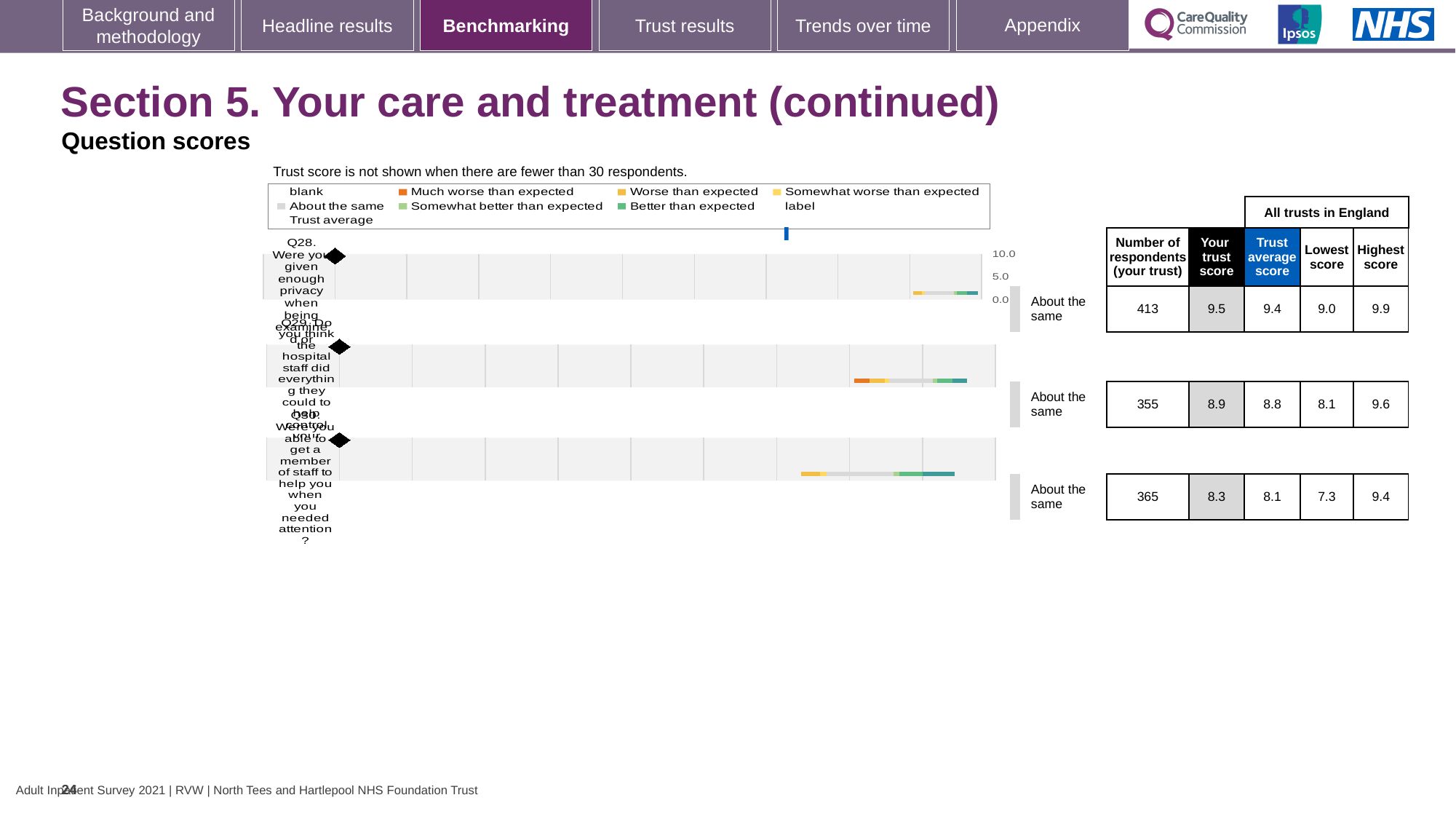
What benchmark category is shown for Q30? About the same How many respondents from your trust answered Q29 (Do you think the hospital staff did everything they could to help control your pain)? 355 What is the trust average score for Q30 (Were you able to get a member of staff to help you when you needed attention)? 8.1 Which of the three questions shown has the highest 'Your trust score'? Q28 What is the 'Your trust score' value for Q28 (Were you given enough privacy when being examined or treated)? 9.5 What is the difference between your trust score and the trust average score for Q28? 0.1 What kind of chart is used to show the question scores? Bar chart For Q29, which is larger: your trust score or the trust average score? Your trust score (8.9) Which of the three questions shown has the lowest 'Lowest score' across all trusts in England? Q30 What is the highest score across all trusts in England for Q29? 9.6 What is the difference between the highest score and the lowest score for Q30? 2.1 How many questions are plotted on this slide? 3